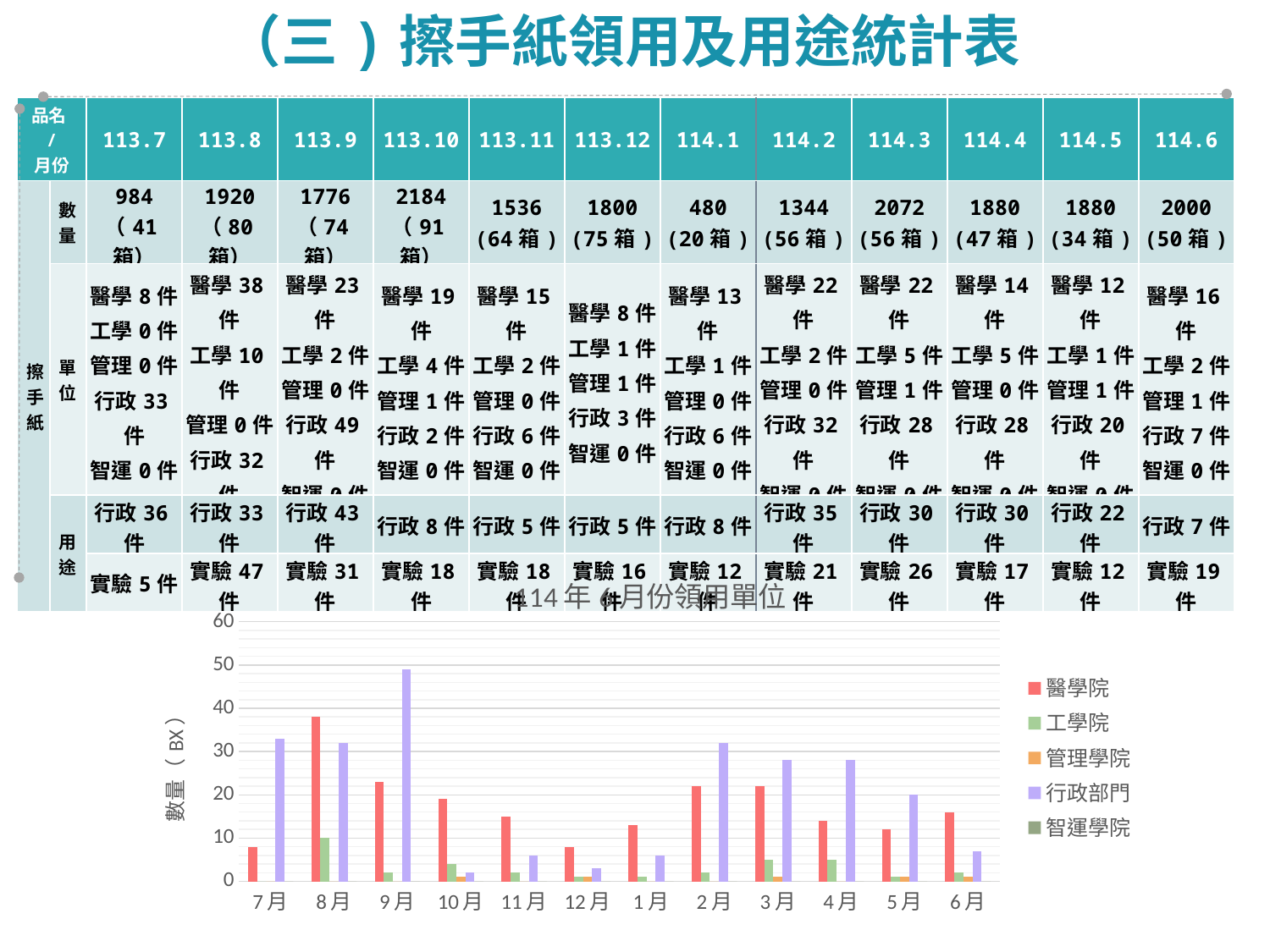
In the bar chart, which is larger in 8月: 醫學院 or 行政部門? 醫學院 What kind of chart is shown at the bottom of the slide? bar chart In the bar chart, is the value for 醫學院 in 7月 greater or less than 10? less In the bar chart, which month has the tallest bar for 行政部門? 9月 In the bar chart, which month has the tallest bar for 醫學院? 8月 In the bar chart, is the value for 行政部門 in 9月 greater or less than 40? greater In the bar chart, is the value for 行政部門 in 3月 greater or less than 20? greater How many months are shown along the x axis of the bar chart? 12 How many series does the legend of the bar chart list? 5 In the bar chart, do the 醫學院 values rise or fall from 9月 to 12月? fall What is the label on the y axis of the bar chart? 數量（BX） In the bar chart, which is larger in 2月: 醫學院 or 行政部門? 行政部門